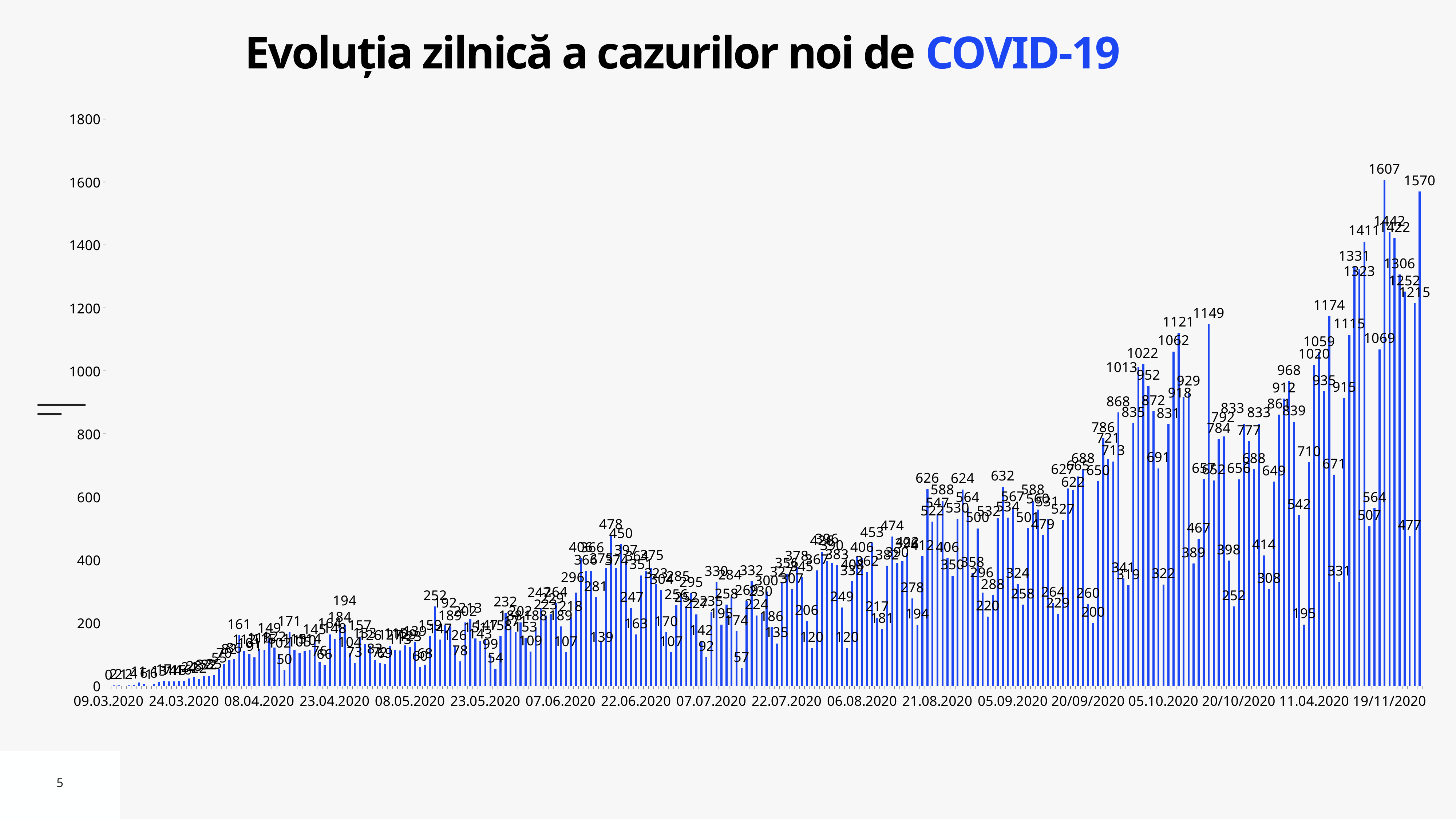
What is the difference between the highest bar (1607) and the last bar (1570)? 37 What is the title of the chart? Evoluția zilnică a cazurilor noi de COVID-19 What is the value of the rightmost (last) bar in the chart? 1570 How many bars in the chart exceed 1500? 2 What is the highest value shown on the vertical axis? 1800 Is the value of the rightmost bar greater or less than 1400? greater Do the daily values generally rise or fall from left to right across the chart? rise Is the value of the first bar at 09.03.2020 greater or less than 200? less What kind of chart is shown on the slide? bar chart What is the highest daily value shown in the chart? 1607 Which is larger, the tallest bar or the rightmost bar? the tallest bar (1607)